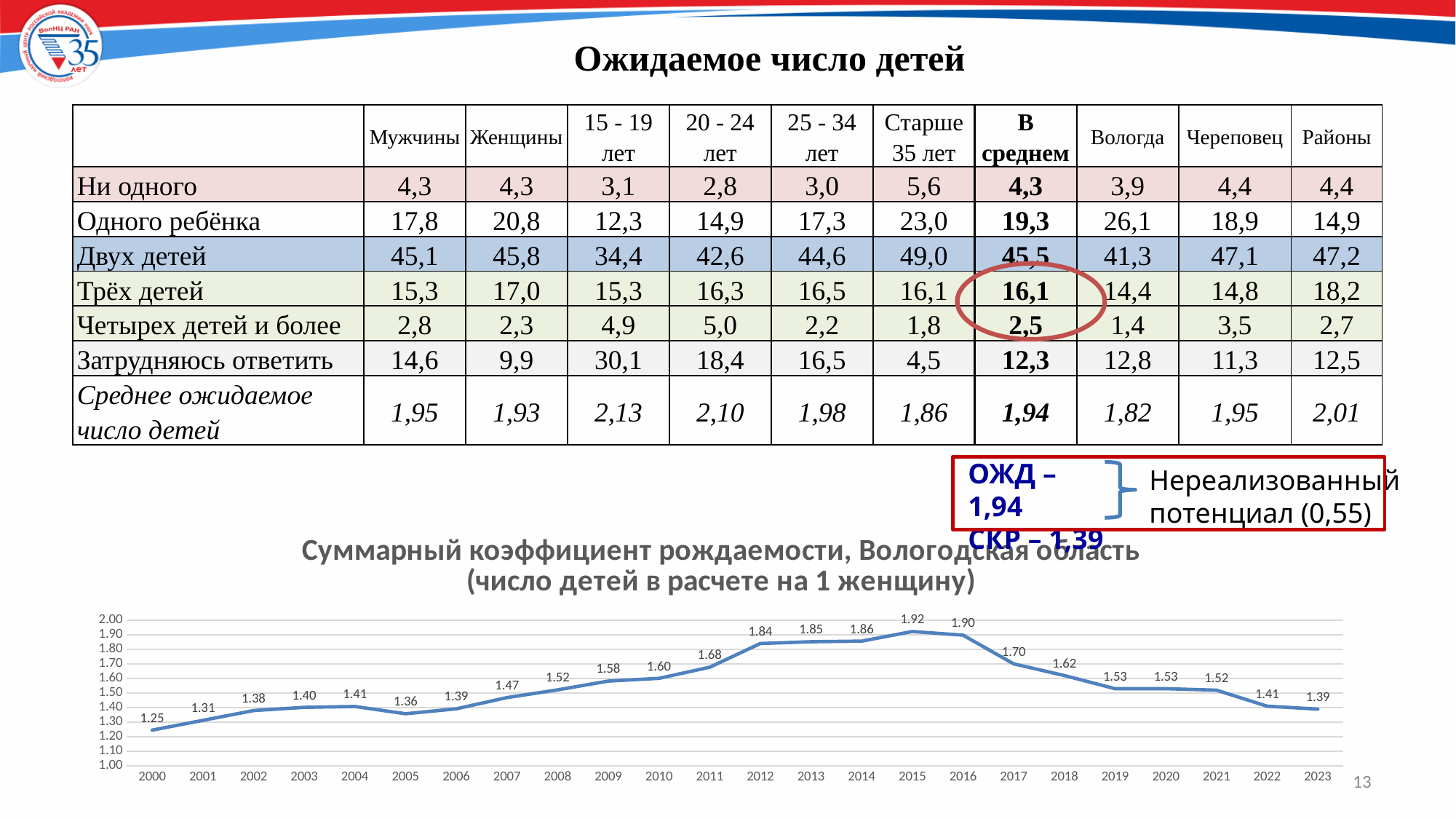
How many years are plotted in the line chart? 24 What is the total fertility rate value shown for 2000 in the line chart? 1.25 Is the value for 2016 in the line chart greater or less than 1.80? greater What kind of chart is shown at the bottom of the slide? Line chart What is the value shown for 2015 in the line chart? 1.92 What is the difference between the values for 2015 and 2023 in the line chart? 0.53 Which year has the lowest value in the line chart? 2000 Does the line chart rise or fall between 2016 and 2023? Fall What is the title of the line chart? Суммарный коэффициент рождаемости, Вологодская область (число детей в расчете на 1 женщину) What is the value shown for 2023 in the line chart? 1.39 Which year has the highest value in the line chart? 2015 Which year has a larger value in the line chart, 2012 or 2017? 2012